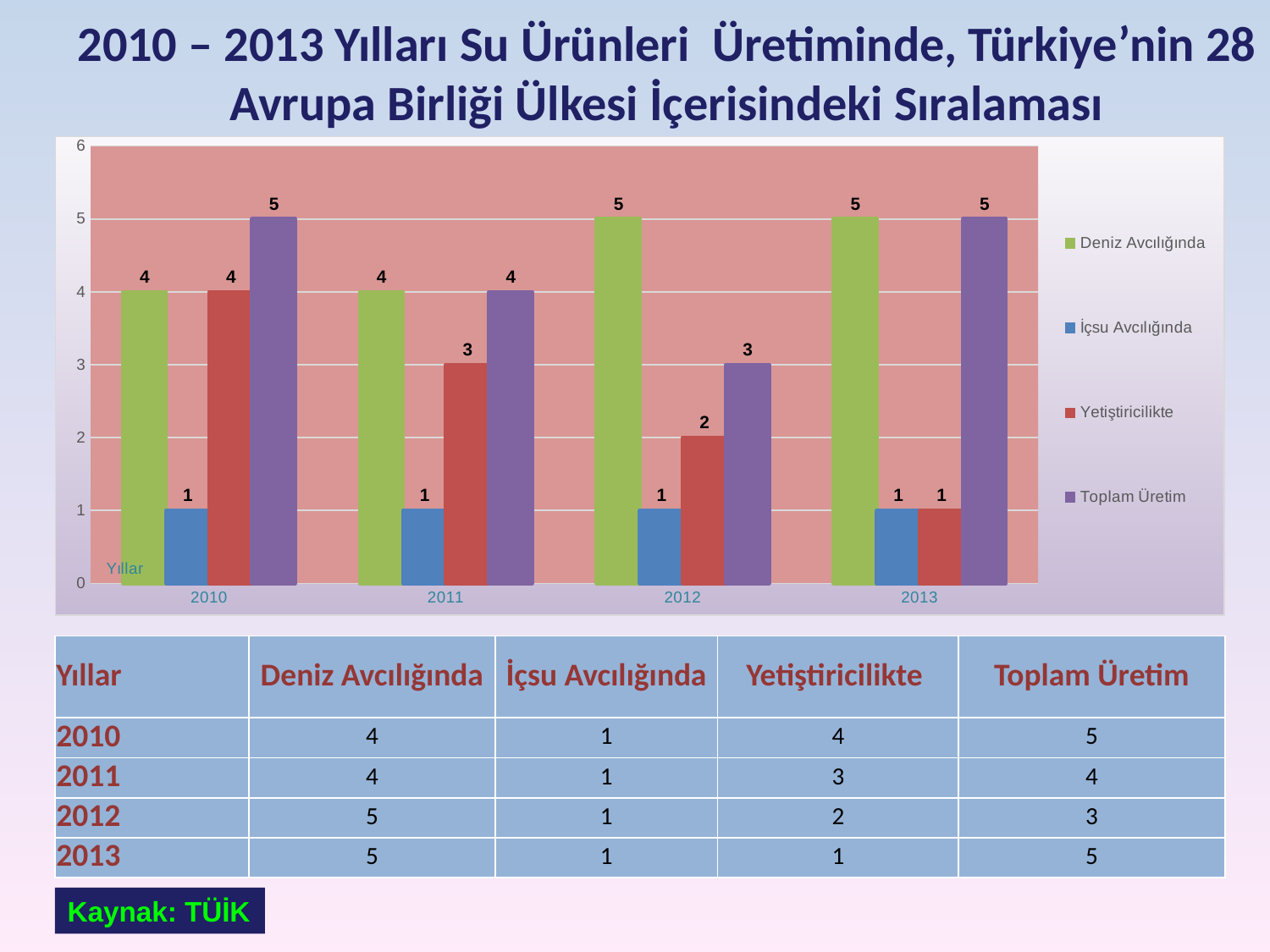
What is the difference between the Deniz Avcılığında and Yetiştiricilikte values in 2013? 4 What is the value for Deniz Avcılığında in 2013? 5 Which series is shown in green in the chart? Deniz Avcılığında In which year is the Toplam Üretim value lowest? 2012 What is the value for Toplam Üretim in 2010? 5 How many years are shown on the x axis of the chart? 4 What is the value for Yetiştiricilikte in 2012? 2 Which series has the highest value in 2011? Deniz Avcılığında and Toplam Üretim (both 4) Which is larger in 2012: Deniz Avcılığında or Toplam Üretim? Deniz Avcılığında How many series does the chart legend list? 4 What kind of chart is shown on the slide? Bar chart Does the Yetiştiricilikte value rise or fall from 2010 to 2013? Fall